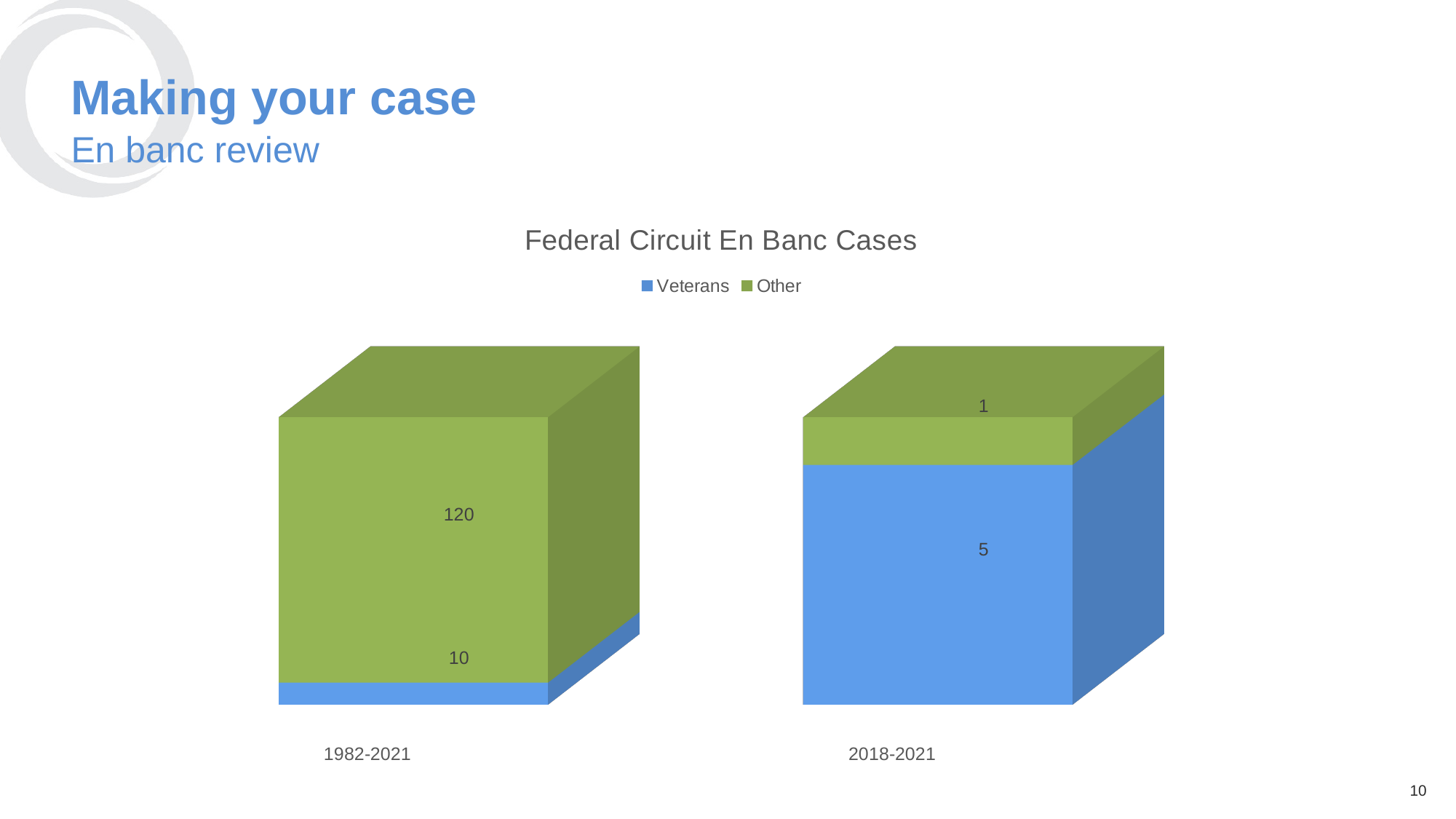
What is the difference between the Other value and the Veterans value for 1982-2021? 110 Which is larger for 2018-2021, Veterans or Other? Veterans How many categories are shown on the x axis? 2 What is the value for Veterans in the 2018-2021 bar? 5 How many series does the legend list? 2 Which category has the higher Other value, 1982-2021 or 2018-2021? 1982-2021 What is the total of the 1982-2021 stacked bar? 130 What is the value for Veterans in the 1982-2021 bar? 10 What is the value for Other in the 2018-2021 bar? 1 What is the total of the 2018-2021 stacked bar? 6 What is the value for Other in the 1982-2021 bar? 120 What is the title of the chart? Federal Circuit En Banc Cases